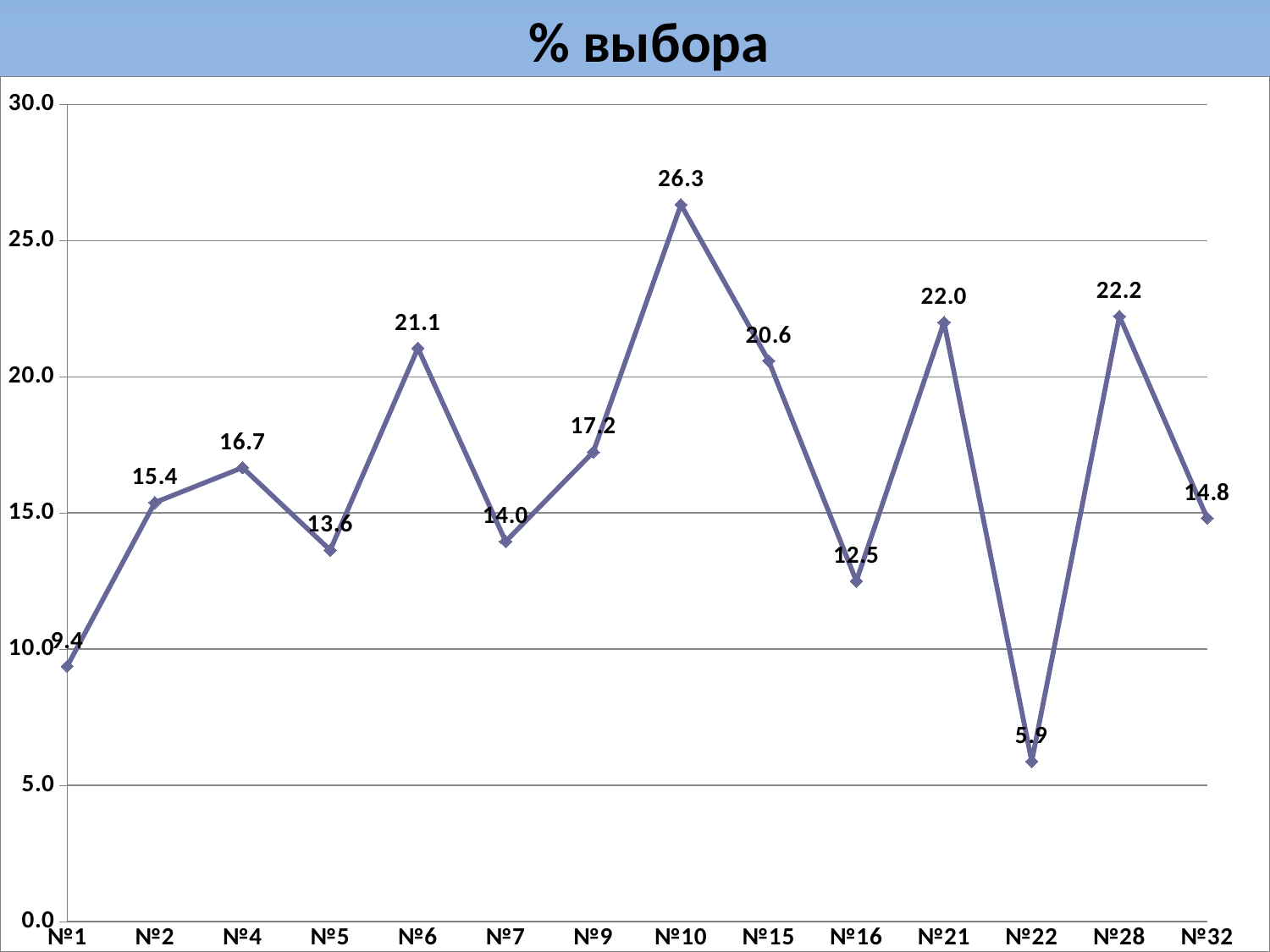
How many categories are plotted on the x axis? 14 Which category has the highest value? №10 What is the value for №32? 14.8 What is the title of the chart? % выбора Which is larger, the value for №6 or the value for №15? №6 What is the difference between the values for №28 and №21? 0.2 What is the value for №10? 26.3 What is the value for №22? 5.9 Which category has the lowest value? №22 What is the value for №6? 21.1 What is the difference between the values for №10 and №22? 20.4 What kind of chart is shown? line chart